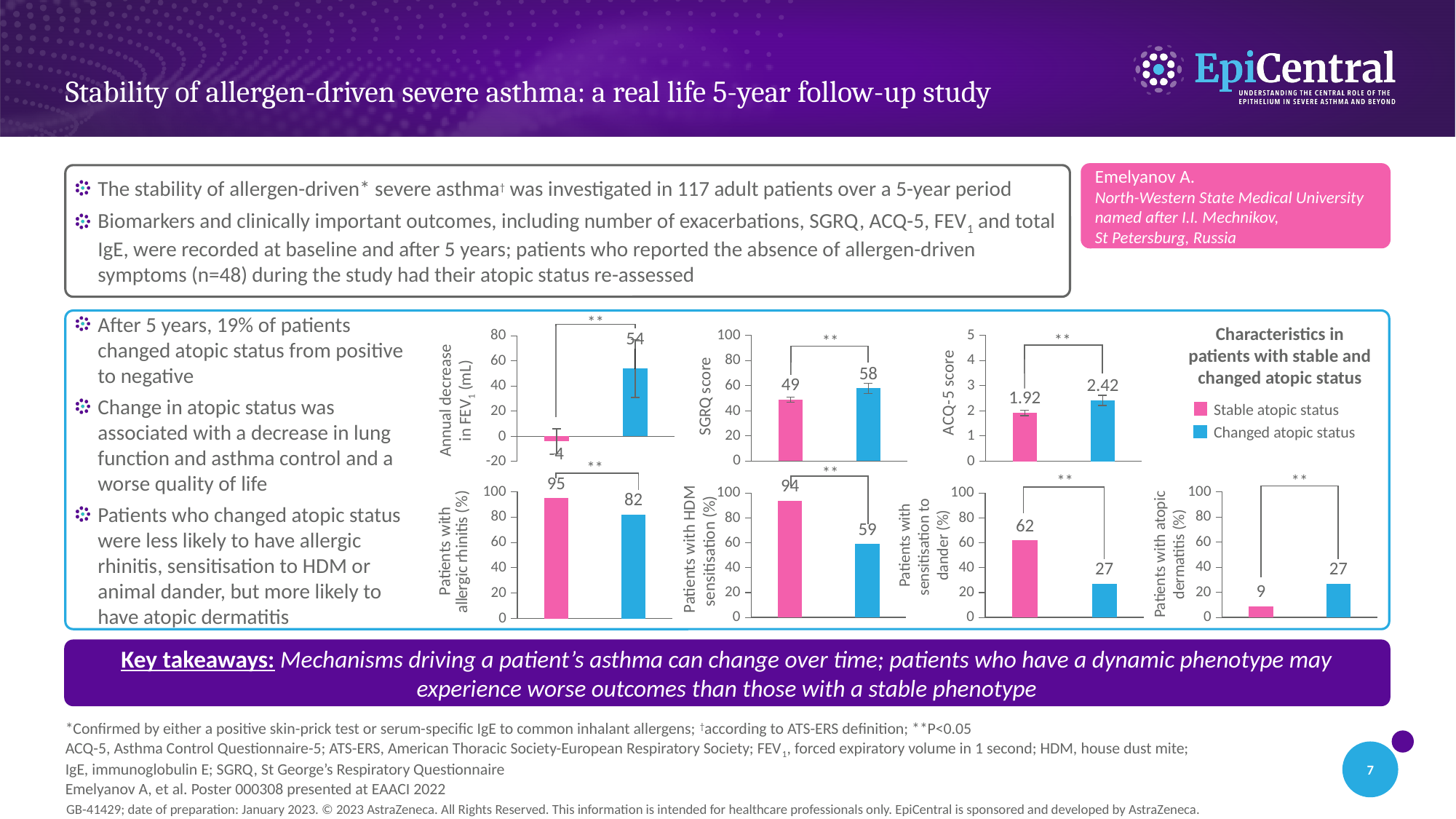
In the chart of patients with allergic rhinitis (%), what is the value for the stable atopic status group? 95 In the chart of annual decrease in FEV1 (mL), what is the value for the stable atopic status group? -4 In the chart of patients with sensitisation to dander (%), what is the value for the changed atopic status group? 27 In the SGRQ score chart, what is the value for the stable atopic status group? 49 In the chart of patients with HDM sensitisation (%), what is the difference between the stable and changed atopic status groups? 35 In the chart of annual decrease in FEV1 (mL), what is the value for the changed atopic status group? 54 What type of chart is used to show the SGRQ score? Bar chart In the ACQ-5 score chart, which group has the higher score, stable or changed atopic status? Changed atopic status How many series does the legend list for the charts on the slide? 2 In the SGRQ score chart, what is the difference between the changed and stable atopic status groups? 9 In the chart of patients with atopic dermatitis (%), which group has the lower value? Stable atopic status In the ACQ-5 score chart, what is the value for the changed atopic status group? 2.42